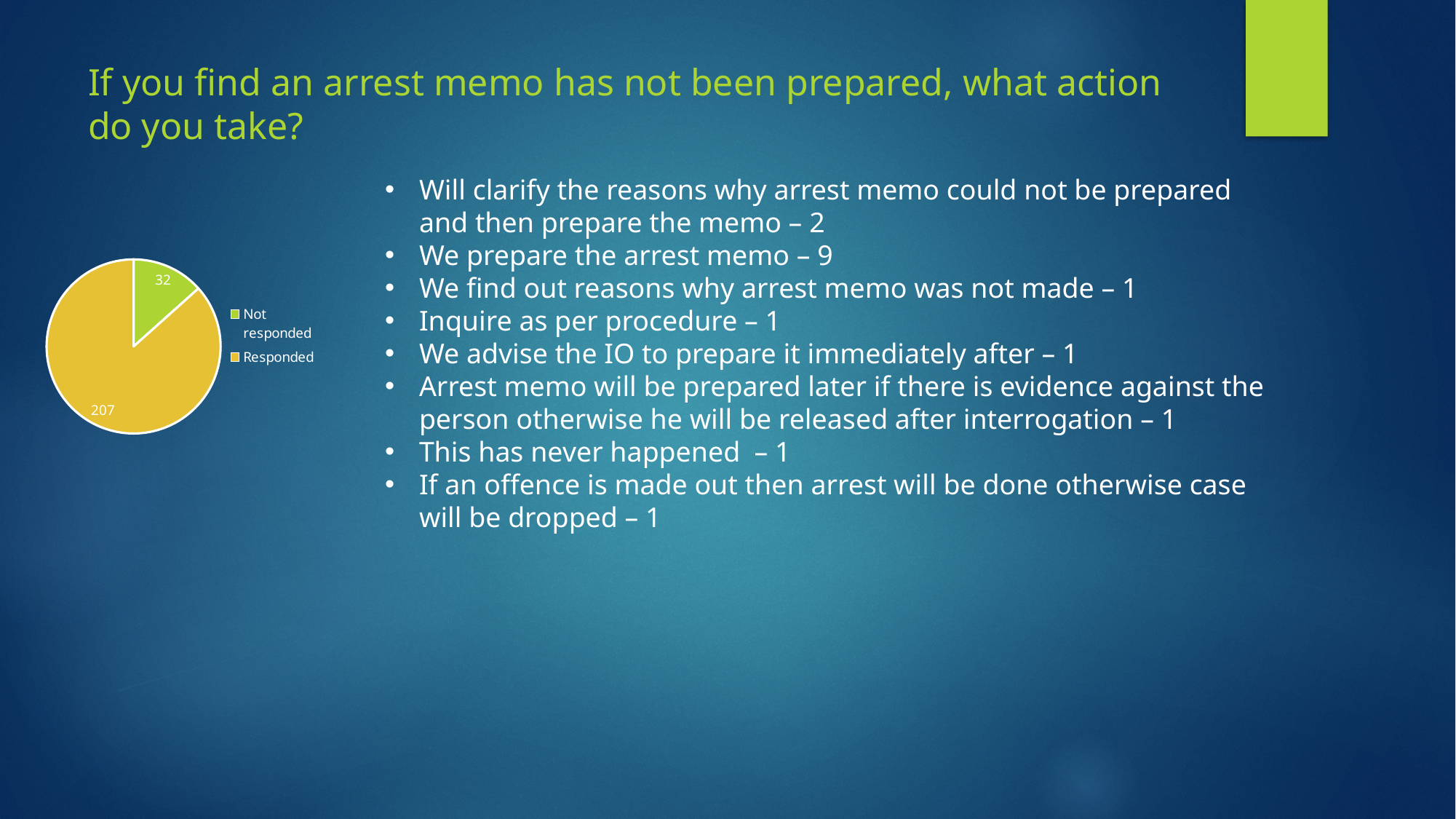
What is the difference between the Responded and Not responded values in the pie chart? 175 What kind of chart is shown on the slide? pie chart Which slice of the pie chart is the smallest? Not responded How many slices does the pie chart have? 2 Which slice of the pie chart is the largest? Responded What colour is the Responded slice in the pie chart? yellow Which is larger in the pie chart, Responded or Not responded? Responded What is the value for Responded in the pie chart? 207 What is the total of the two values shown in the pie chart? 239 What colour is the Not responded slice in the pie chart? green What is the value for Not responded in the pie chart? 32 How many entries does the pie chart legend list? 2